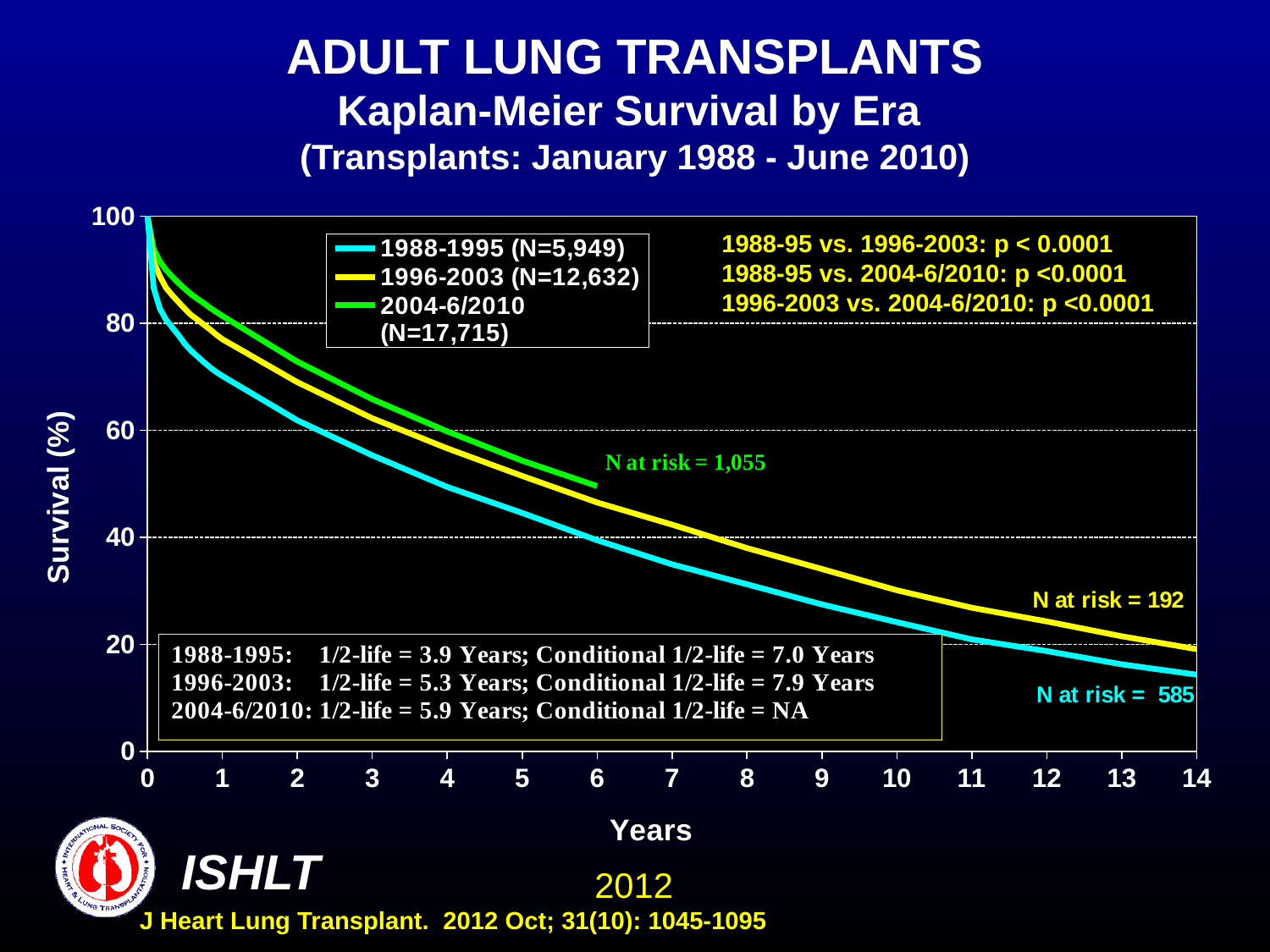
What is the conditional 1/2-life for the 1988-1995 era? 7.0 Years What is the N at risk printed for the 1996-2003 curve? 192 What is the 1/2-life for the 1996-2003 era? 5.3 Years Which era has the highest survival at 5 years? 2004-6/2010 What is the N at risk printed for the 2004-6/2010 curve? 1,055 How many series (eras) does the legend list? 3 Which era has the lowest survival at 10 years? 1988-1995 Is the survival for the 1996-2003 era at 10 years greater or less than 40? less Do the survival curves rise or fall as years since transplant increase? fall How many patients (N) does the legend give for the 1996-2003 era? 12,632 What is the N at risk printed for the 1988-1995 curve? 585 What kind of chart is shown on the slide? line chart